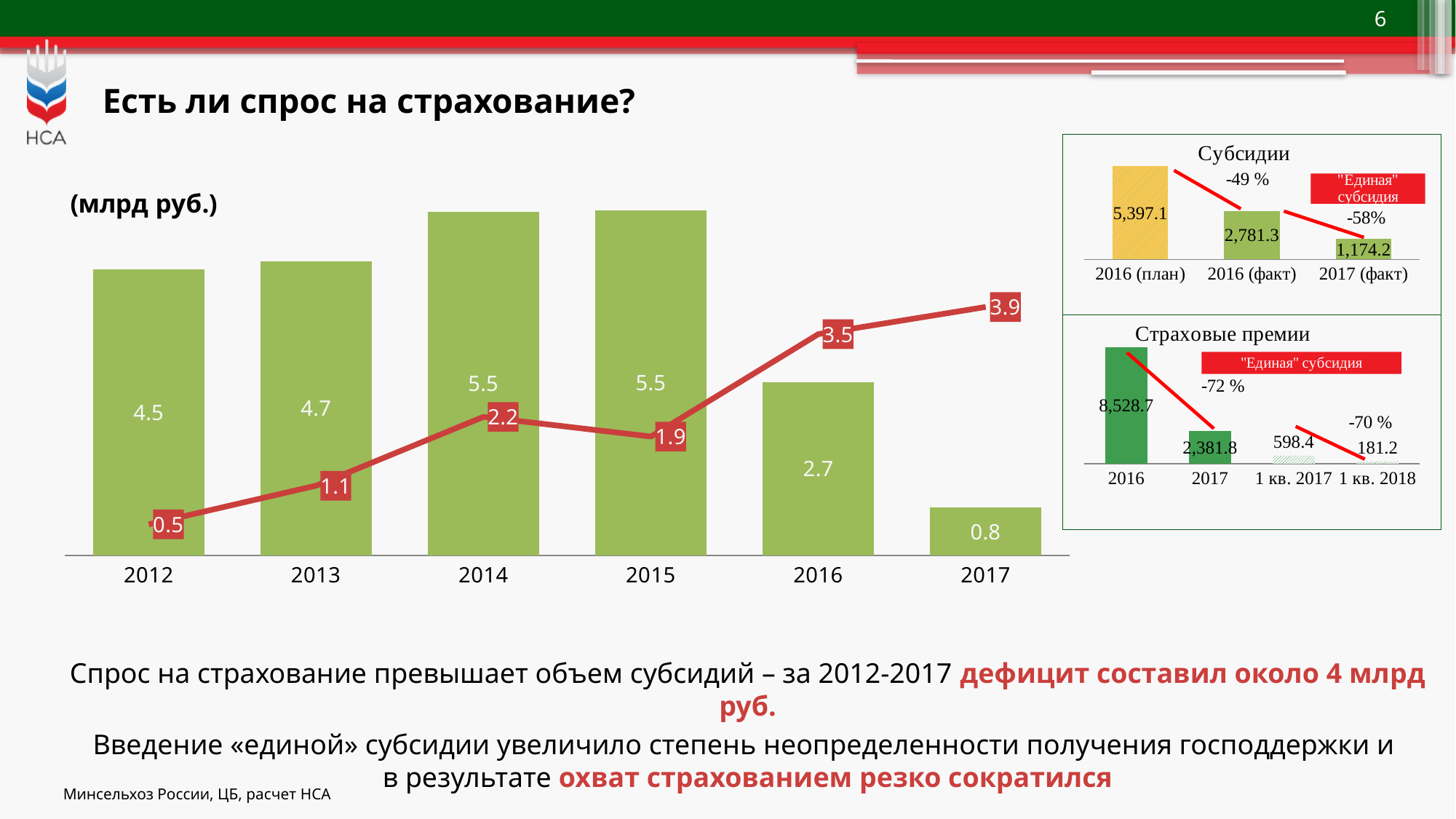
In the 'Страховые премии' chart, what is the value for 1 кв. 2018? 181.2 In the main chart on the left, how many years are shown on the x axis? 6 In the main chart on the left, what is the value of the red line at 2017? 3.9 In the 'Страховые премии' chart, what is the difference between the 2016 and 2017 values? 6,146.9 In the 'Субсидии' chart, what is the value for 2016 (факт)? 2,781.3 In the main chart on the left, is the bar value for 2013 larger than the line value for 2013? Yes, 4.7 vs 1.1 In the main chart on the left, which year has the lowest bar value? 2017 In the main chart on the left, what is the bar value for 2014? 5.5 In the 'Субсидии' chart, which category has the highest value? 2016 (план) In the main chart on the left, what is the difference between the bar value and the line value for 2016? 0.8 What type of chart is the main chart on the left? Combined bar and line chart In the main chart on the left, does the red line generally rise or fall from 2012 to 2017? Rise